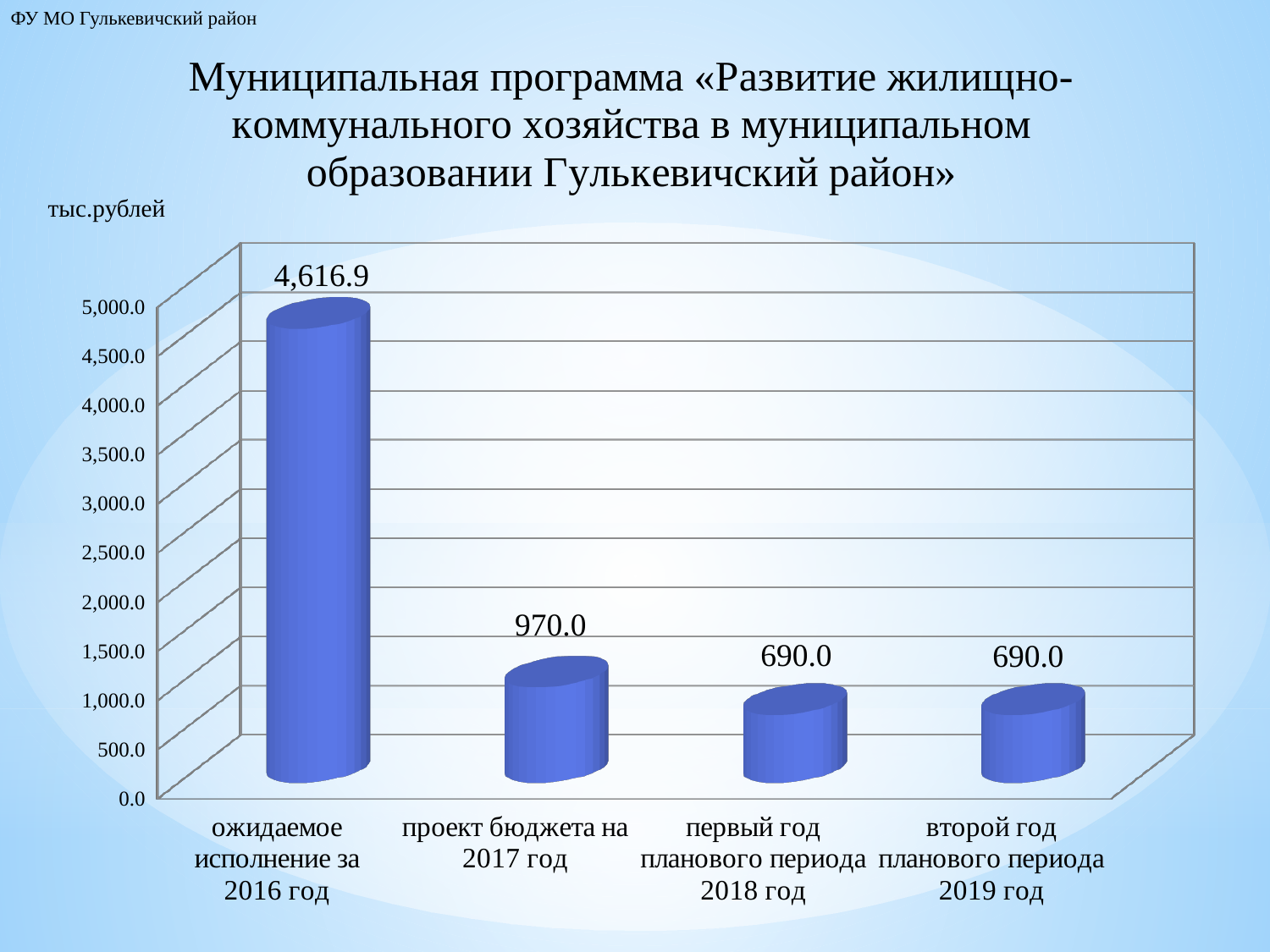
Which category has the highest value? ожидаемое исполнение за 2016 год What unit is indicated above the chart's vertical axis? тыс.рублей Is the value for 'проект бюджета на 2017 год' greater or less than 1,000.0? less Do the values rise or fall from 2016 to 2018 along the x axis? fall What kind of chart is shown on the slide? bar chart Which is larger, the value for 2017 or the value for 2019? проект бюджета на 2017 год What is the value for 'ожидаемое исполнение за 2016 год'? 4,616.9 What is the difference between the values for 2016 and 2017? 3,646.9 What is the difference between the values for 2017 and 2018? 280.0 How many categories are shown on the x axis? 4 What is the value for 'проект бюджета на 2017 год'? 970.0 What is the value for 'первый год планового периода 2018 год'? 690.0